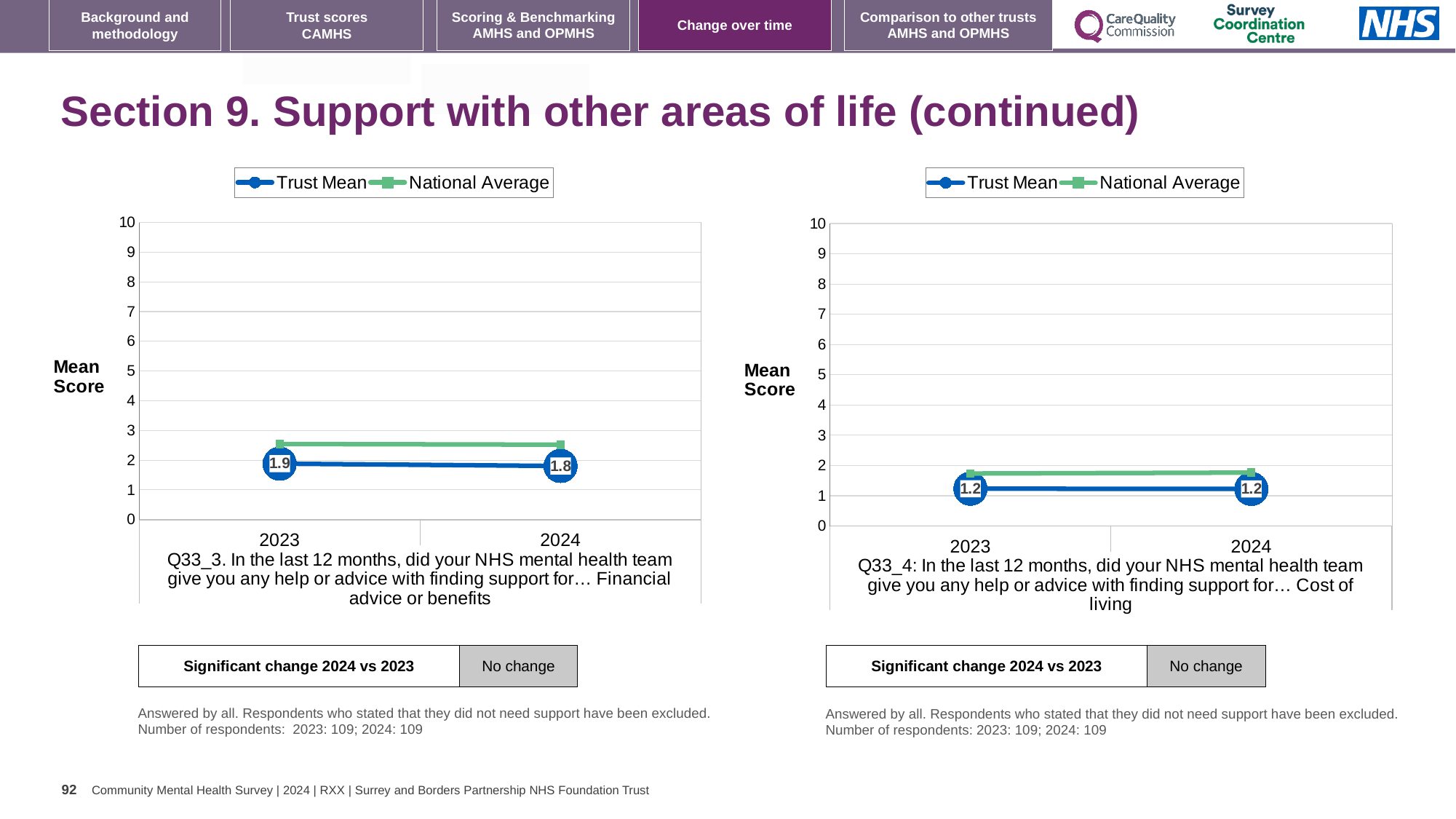
On the right chart (Q33_4, Cost of living), what is the Trust Mean for 2024? 1.2 On the left chart (Q33_3, Financial advice or benefits), what is the Trust Mean for 2024? 1.8 What kind of chart is the right chart (Q33_4, Cost of living)? line chart On the left chart (Q33_3, Financial advice or benefits), what is the Trust Mean for 2023? 1.9 How many series does the legend of the right chart (Q33_4) list? 2 On the left chart (Q33_3), does the Trust Mean rise or fall from 2023 to 2024? fall On the right chart (Q33_4), is the National Average for 2024 greater or less than 2? less On the left chart (Q33_3), which is higher in 2024, the Trust Mean or the National Average? National Average How many years are plotted on the x axis of the left chart (Q33_3)? 2 On the left chart (Q33_3), by how much did the Trust Mean change from 2023 to 2024? 0.1 On the right chart (Q33_4), does the Trust Mean rise, fall or stay the same from 2023 to 2024? stay the same On the left chart (Q33_3), is the National Average for 2023 greater or less than 2? greater